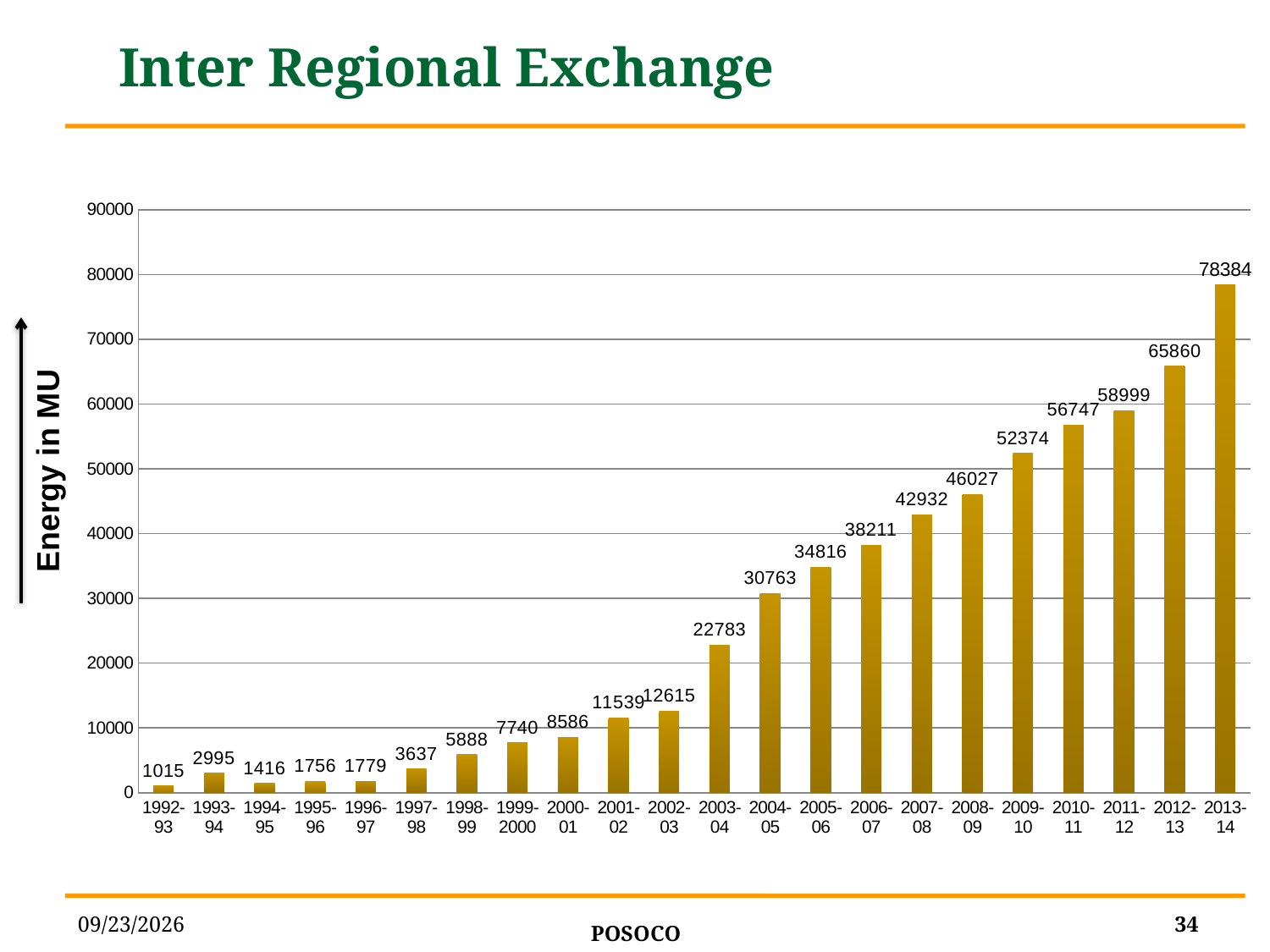
What is the value for 2003-04? 22783 What is the label of the y axis? Energy in MU Is the value for 2009-10 greater or less than 50000? greater What is the value for 1992-93? 1015 Which is larger, the value for 1993-94 or the value for 1994-95? 1993-94 How many years are shown on the x axis? 22 Which year has the lowest value? 1992-93 What is the difference between the values for 2004-05 and 2003-04? 7980 What is the value for 2013-14? 78384 What kind of chart is shown on the slide? bar chart Which year has the highest value? 2013-14 What is the difference between the values for 2013-14 and 2012-13? 12524